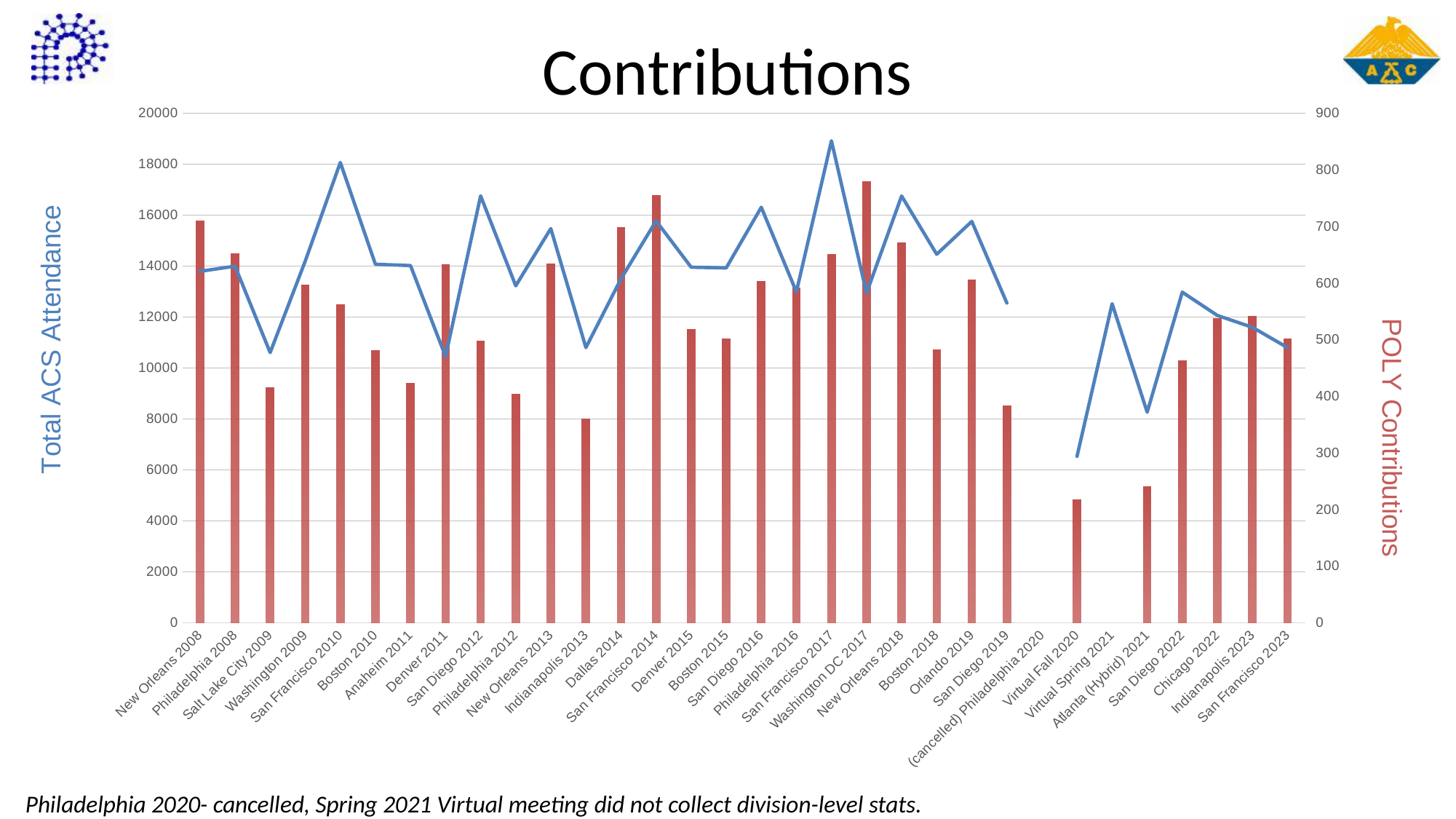
What is the title of the chart? Contributions Which meeting has the highest POLY Contributions bar? Washington DC 2017 Is the Total ACS Attendance for Salt Lake City 2009 greater or less than 12000? less Which has the larger POLY Contributions bar, Washington DC 2017 or Boston 2018? Washington DC 2017 Is the Total ACS Attendance for San Francisco 2010 greater or less than 16000? greater Is the POLY Contributions value for Washington DC 2017 greater or less than 700? greater Which meeting has the lowest Total ACS Attendance point on the line? Virtual Fall 2020 What is the label of the right-hand vertical axis? POLY Contributions What kind of chart is shown on the slide? A combined bar and line chart Does the Total ACS Attendance line rise or fall from Chicago 2022 to San Francisco 2023? fall Which meeting has the highest Total ACS Attendance on the line? San Francisco 2017